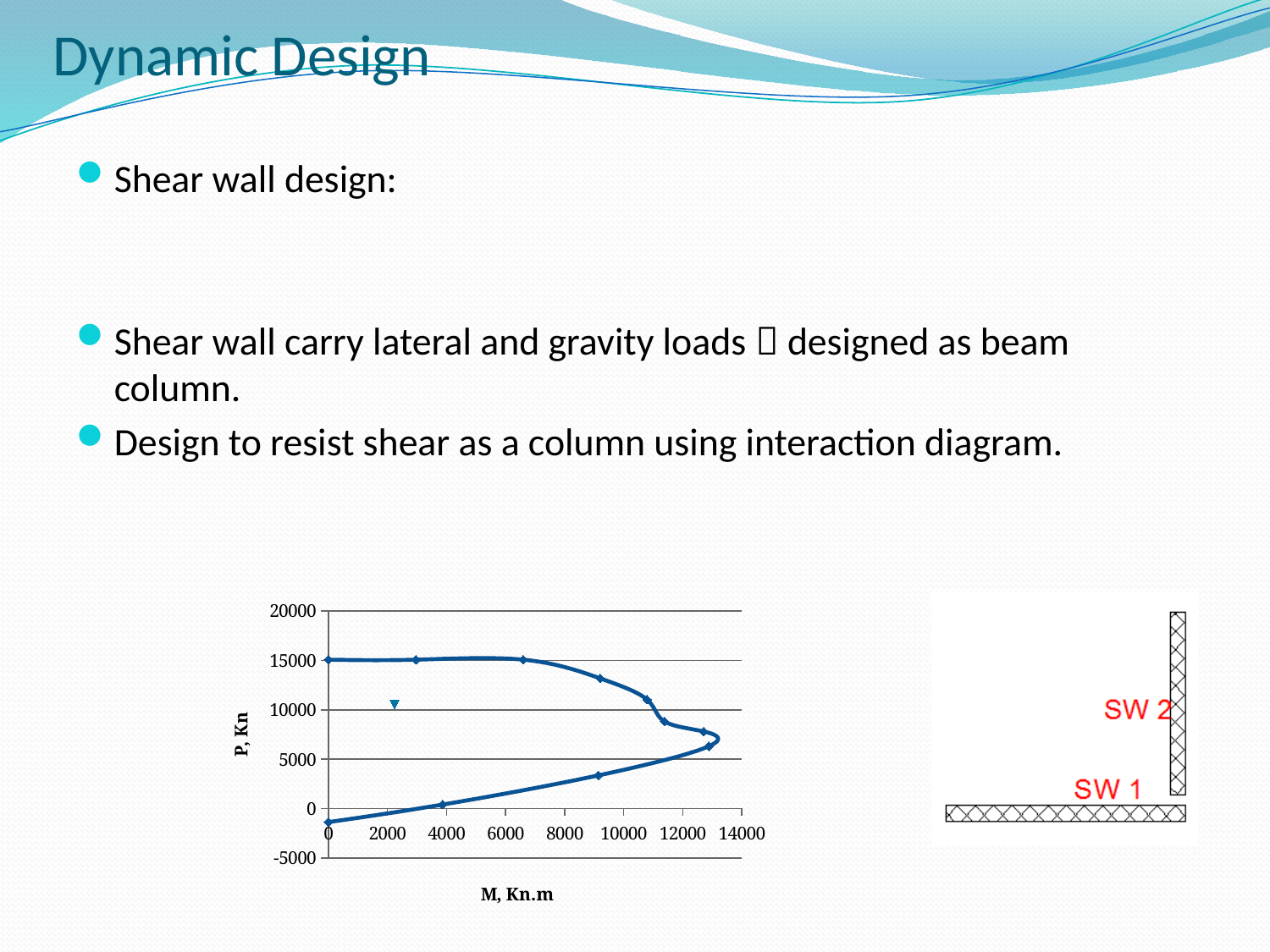
Is the P value of the isolated triangle marker greater or less than 5000? greater What is the title of the vertical axis of the chart? P, Kn Is the lowest P value on the curve greater or less than 0? less What kind of chart is shown on the slide? line chart Is the M value of the isolated triangle marker greater or less than 4000? less What is the title of the horizontal axis of the chart? M, Kn.m